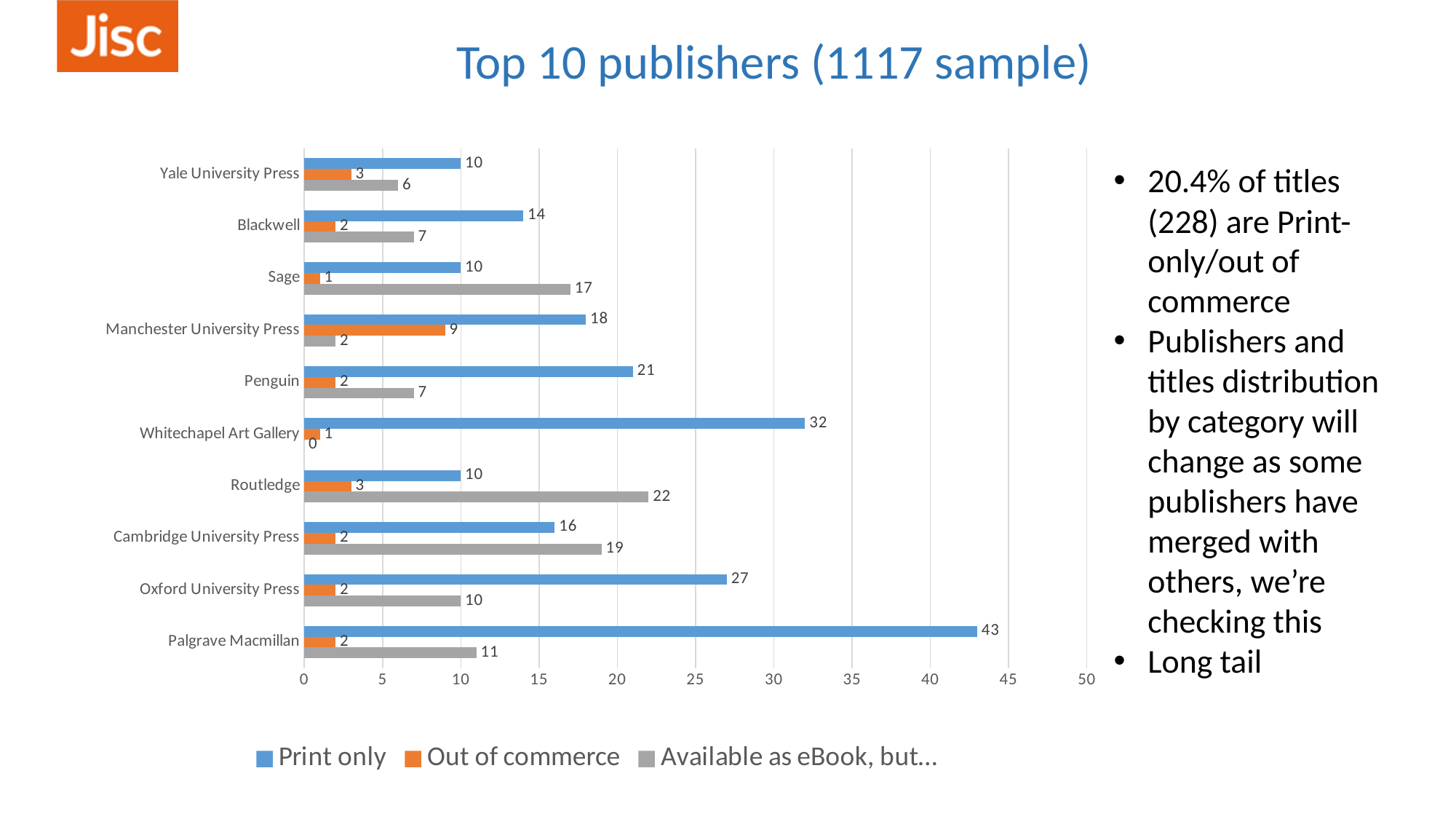
How many publishers are shown on the chart? 10 What is the 'Available as eBook, but...' value for Routledge? 22 What is the total of the three values for Penguin? 30 What is the title of the chart? Top 10 publishers (1117 sample) What is the Out of commerce value for Manchester University Press? 9 How many series does the legend list? 3 What is the difference between the Print only values for Palgrave Macmillan and Oxford University Press? 16 What kind of chart is shown on the slide? Bar chart Which publisher has the highest Print only value? Palgrave Macmillan What is the Print only value for Palgrave Macmillan? 43 Which publisher has the lowest 'Available as eBook, but...' value? Whitechapel Art Gallery Which is larger for Sage: the Print only value or the 'Available as eBook, but...' value? Available as eBook, but...